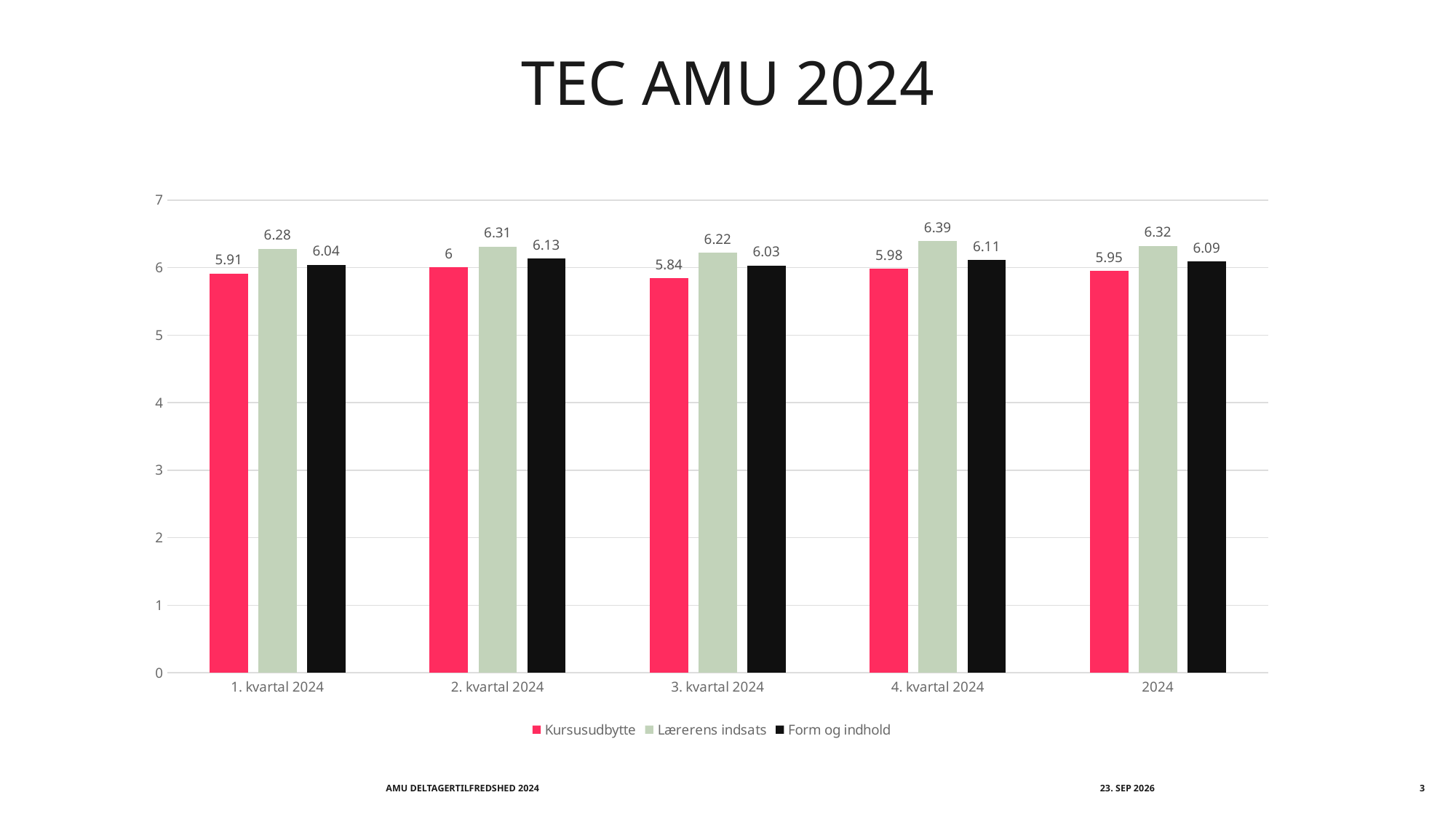
What is the title of the chart? TEC AMU 2024 In which category is Kursusudbytte lowest? 3. kvartal 2024 What is the value of Kursusudbytte for 1. kvartal 2024? 5.91 What is the value of Form og indhold for 2. kvartal 2024? 6.13 What is the value of Kursusudbytte for 2024? 5.95 What is the value of Lærerens indsats for 4. kvartal 2024? 6.39 In which category is Lærerens indsats highest? 4. kvartal 2024 What is the difference between Lærerens indsats and Kursusudbytte for 3. kvartal 2024? 0.38 What kind of chart is shown on the slide? Bar chart Which is larger for 2024: Lærerens indsats or Form og indhold? Lærerens indsats How many categories are shown on the x axis? 5 How many series does the legend list? 3